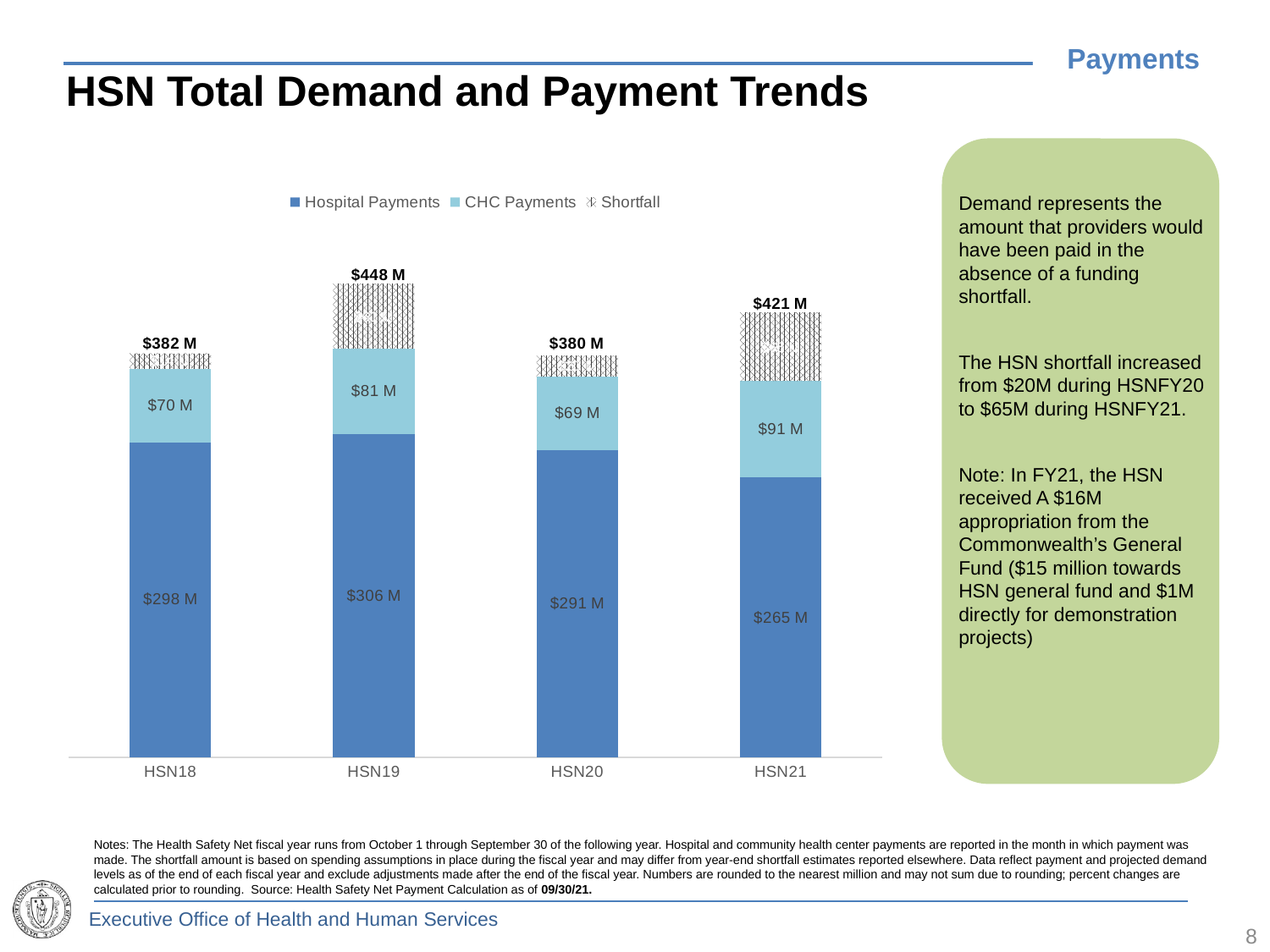
Which fiscal year has the highest total demand? HSN19 How many fiscal years are shown on the x axis? 4 Which fiscal year has the lowest Hospital Payments value? HSN21 Do Hospital Payments rise or fall from HSN19 to HSN21? Fall Which is larger, CHC Payments in HSN19 or in HSN21? HSN21 What is the total demand labeled above the HSN20 bar? $380 M What is the difference between Hospital Payments in HSN19 and HSN18? $8 M What is the CHC Payments value for HSN21? $91 M What is the title of the chart? HSN Total Demand and Payment Trends How many series does the legend list? 3 What kind of chart is shown on the slide? Stacked bar chart What is the Hospital Payments value for HSN19? $306 M